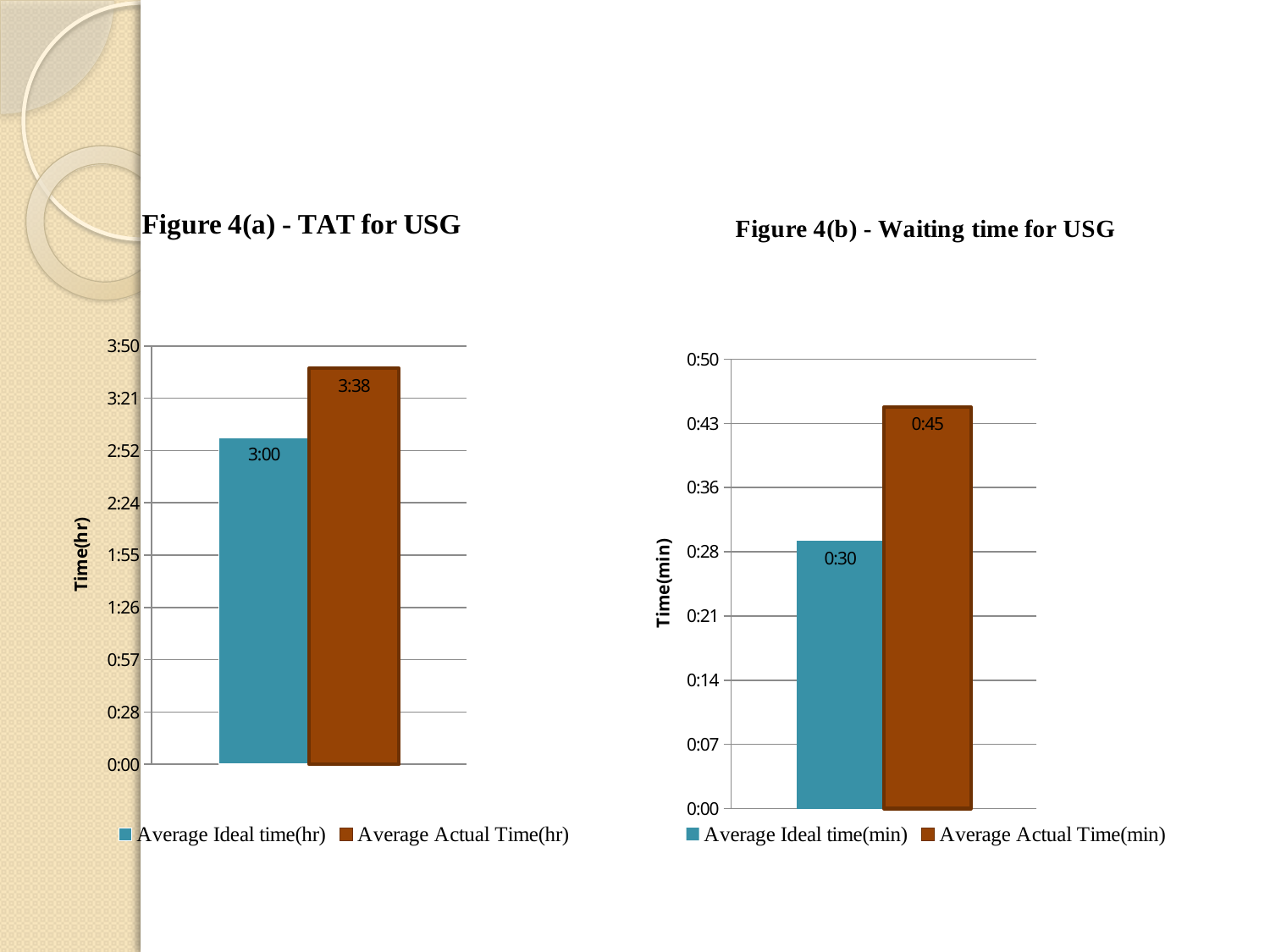
In the Figure 4(b) - Waiting time for USG chart, what is the value for Average Ideal time(min)? 0:30 In the Figure 4(b) - Waiting time for USG chart, which series has the lower value? Average Ideal time(min) What type of chart is Figure 4(b) - Waiting time for USG? Bar chart In the Figure 4(a) - TAT for USG chart, which series has the higher value? Average Actual Time(hr) In the Figure 4(b) - Waiting time for USG chart, is the Average Actual Time(min) greater or less than 0:36? greater In the Figure 4(a) - TAT for USG chart, what is the value for Average Ideal time(hr)? 3:00 In the Figure 4(b) - Waiting time for USG chart, what is the value for Average Actual Time(min)? 0:45 In the Figure 4(a) - TAT for USG chart, how much longer is the Average Actual Time(hr) than the Average Ideal time(hr)? 38 minutes In the Figure 4(b) - Waiting time for USG chart, how much longer is the Average Actual Time(min) than the Average Ideal time(min)? 15 minutes How many series does the legend of the Figure 4(a) - TAT for USG chart list? 2 In the Figure 4(a) - TAT for USG chart, what is the value for Average Actual Time(hr)? 3:38 What is the y-axis label of the Figure 4(a) - TAT for USG chart? Time(hr)